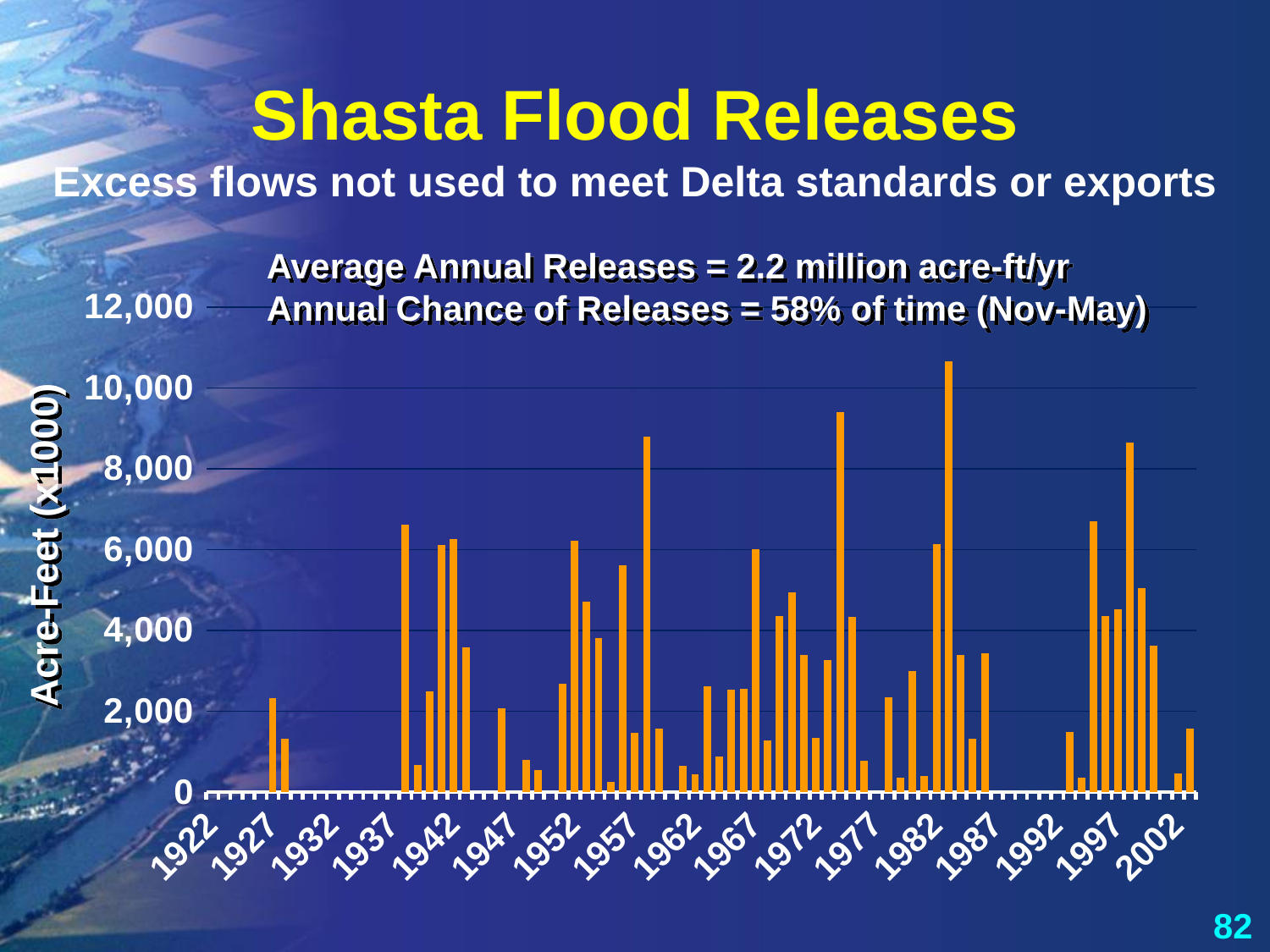
Is the value for 1947 greater or less than 4,000? less Is the value for 2002 greater or less than 2,000? less Is the value for 1922 greater or less than 2,000? less What kind of chart is shown on the slide? bar chart According to the text on the chart, what is the average annual release? 2.2 million acre-ft/yr How many year labels are shown on the x axis? 17 What is the title of the chart? Shasta Flood Releases